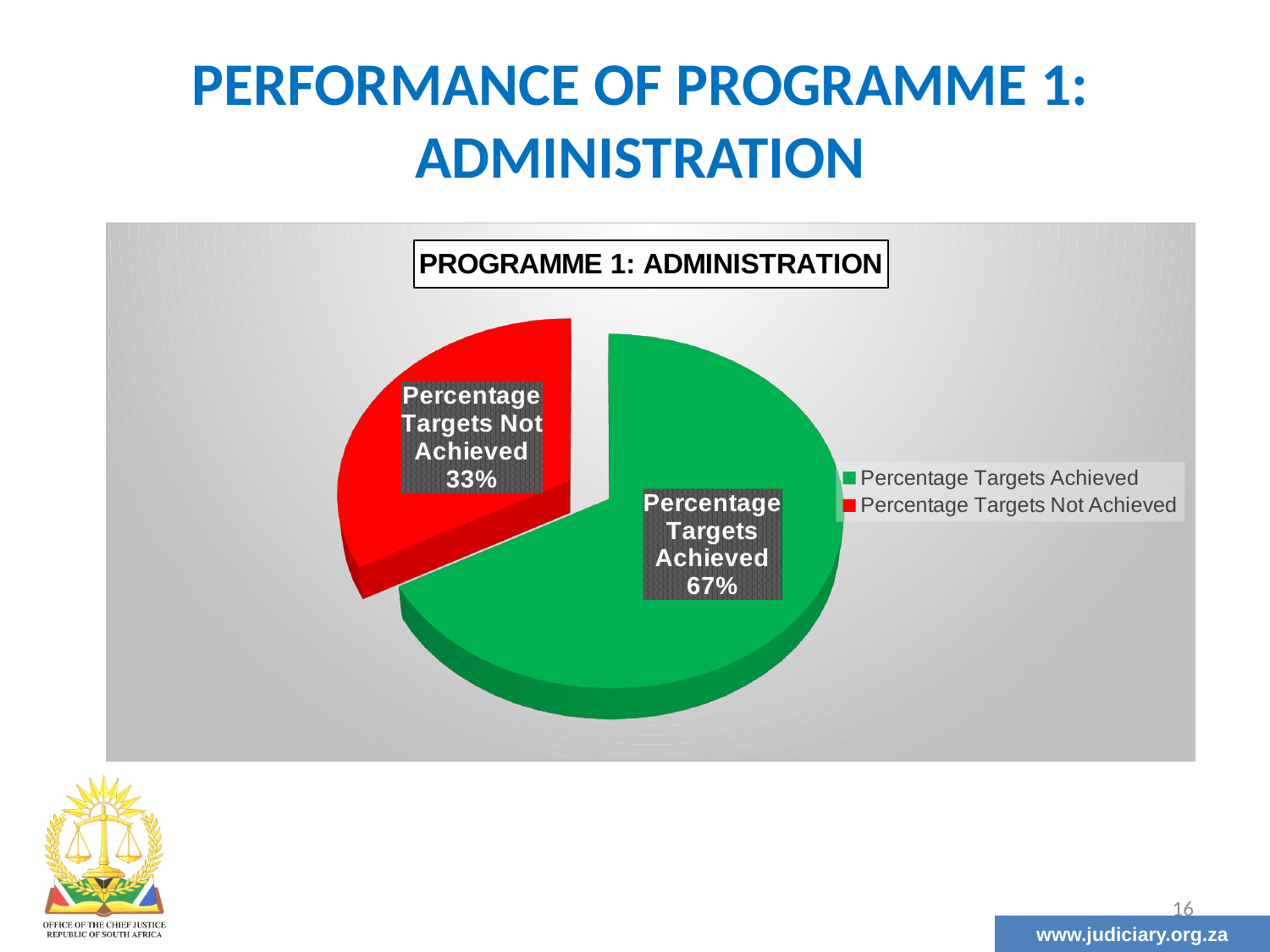
What kind of chart is shown on the slide? Pie chart Which is larger: the share of targets achieved or the share of targets not achieved? Percentage Targets Achieved How many slices does the pie chart have? 2 Which slice of the pie chart is the largest? Percentage Targets Achieved What colour is the slice for Percentage Targets Not Achieved? Red How many entries does the chart legend list? 2 Which slice of the pie chart is the smallest? Percentage Targets Not Achieved What percentage of targets were not achieved according to the pie chart? 33% What is the title of the chart? PROGRAMME 1: ADMINISTRATION What share of the pie does the Percentage Targets Achieved slice represent? 67% What percentage of targets were achieved according to the pie chart? 67% What is the difference in percentage points between targets achieved and targets not achieved? 34